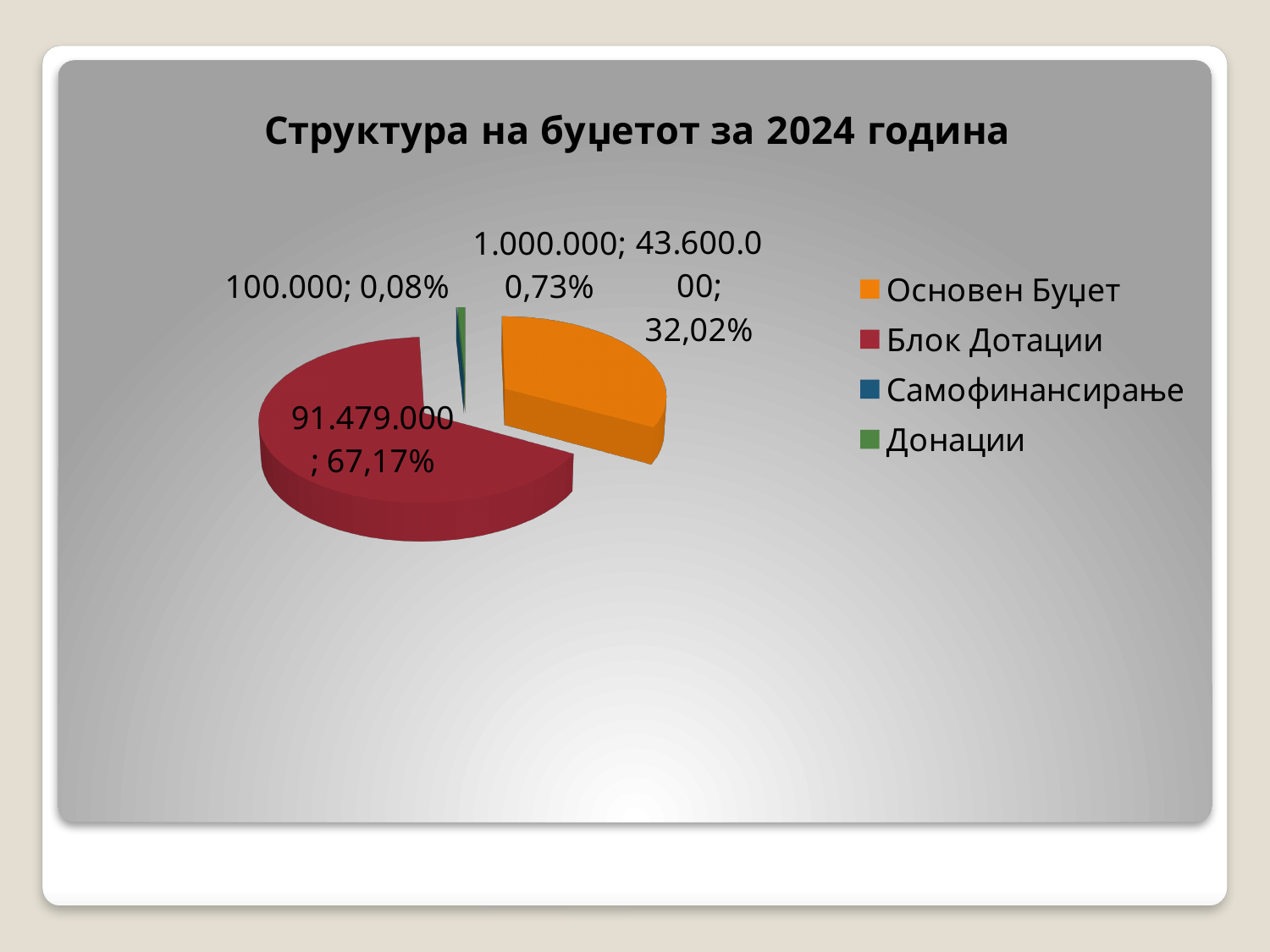
What share of the pie does Основен Буџет represent? 32,02% Which category has the smallest slice of the pie? Самофинансирање What is the difference between the values for Блок Дотации and Основен Буџет? 47.879.000 Which colour represents Основен Буџет in the chart? orange What share of the pie does Самофинансирање represent? 0,08% How many categories does the legend list? 4 What is the title of the chart? Структура на буџетот за 2024 година Which category has the largest slice of the pie? Блок Дотации What share of the pie does Блок Дотации represent? 67,17% What value is shown for Основен Буџет? 43.600.000 What type of chart is shown on the slide? pie chart What value is shown for Блок Дотации? 91.479.000